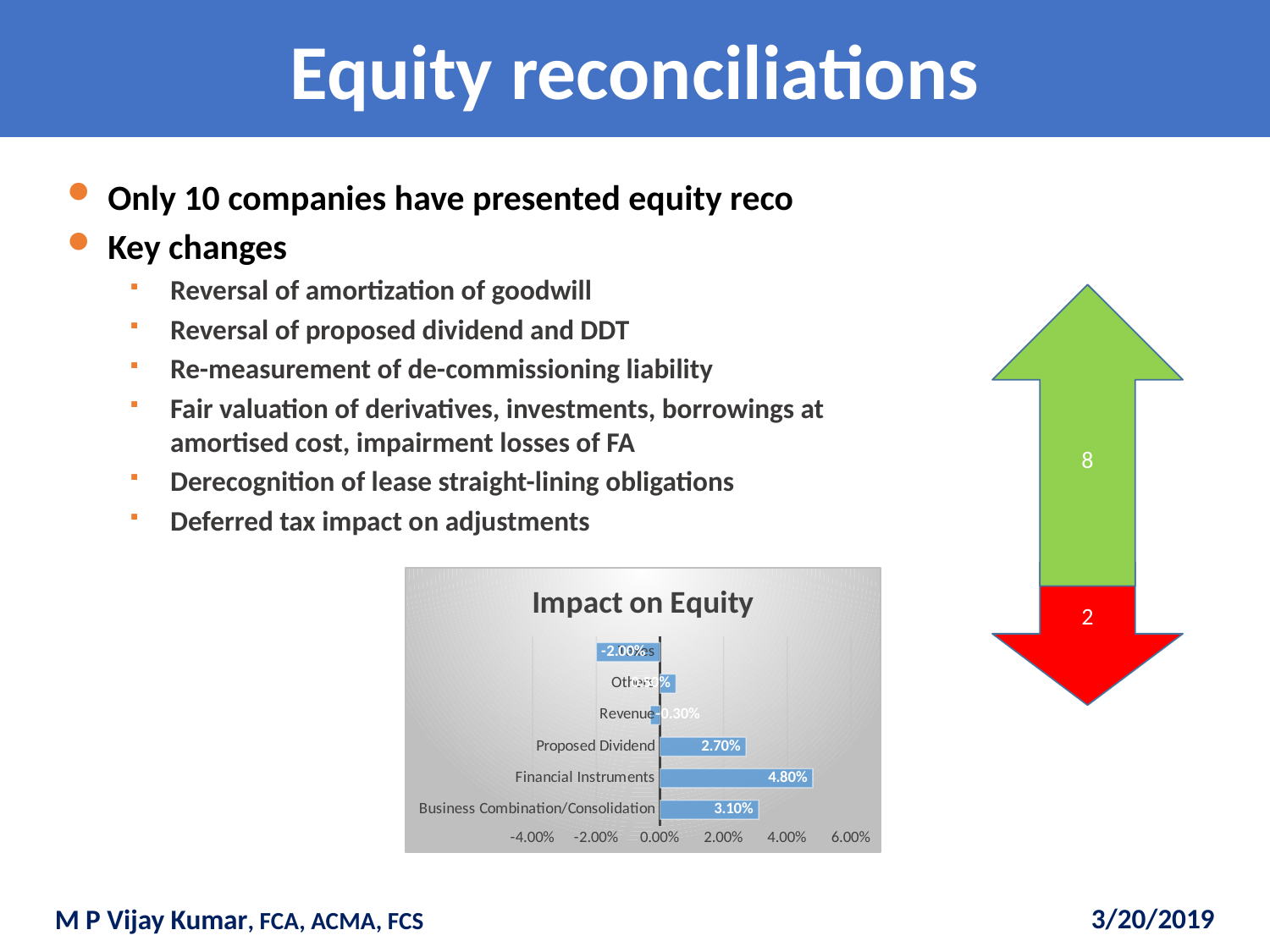
In the Impact on Equity chart, which is larger: the value for Proposed Dividend or the value for Business Combination/Consolidation? Business Combination/Consolidation In the Impact on Equity chart, is the value for Financial Instruments greater or less than 4.00%? greater In the Impact on Equity chart, what is the value for Business Combination/Consolidation? 3.10% What is the title of the chart on the slide? Impact on Equity In the Impact on Equity chart, which category has the highest value? Financial Instruments In the Impact on Equity chart, what is the difference between the values for Financial Instruments and Proposed Dividend? 2.10% How many bars are plotted in the Impact on Equity chart? 6 In the Impact on Equity chart, what is the difference between the values for Financial Instruments and Business Combination/Consolidation? 1.70% In the Impact on Equity chart, what is the value for Financial Instruments? 4.80% What kind of chart is the Impact on Equity chart? bar chart In the Impact on Equity chart, what is the value for Proposed Dividend? 2.70% In the Impact on Equity chart, what is the value for Revenue? -0.30%